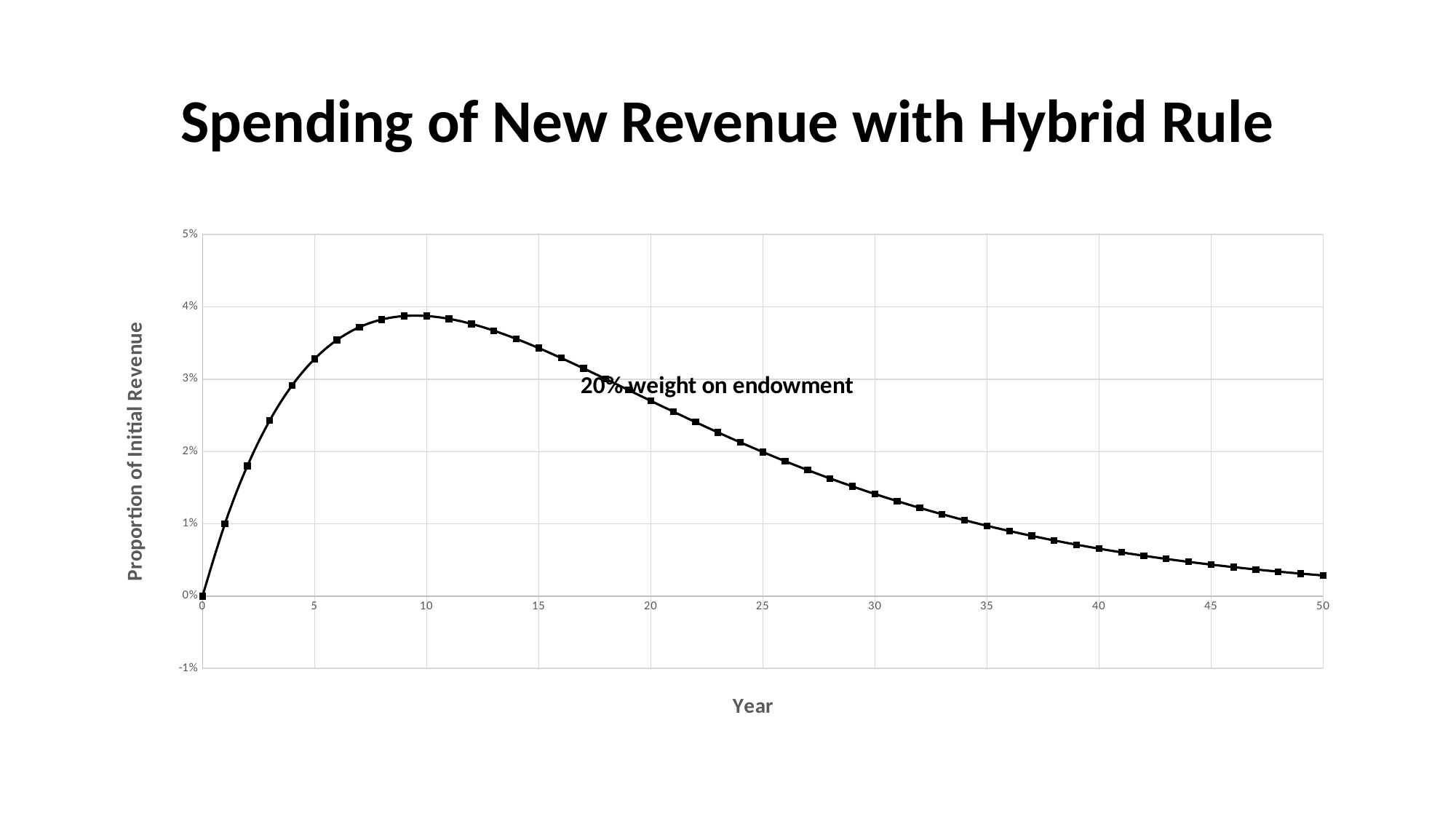
Is the value at year 30 greater or less than 2%? less Is the value at year 50 greater or less than 1%? less Which is larger, the value at year 10 or the value at year 30? year 10 Which is larger, the value at year 5 or the value at year 40? year 5 Do the values rise or fall between year 10 and year 50? fall What is the title of the chart? Spending of New Revenue with Hybrid Rule Is the value at year 5 greater or less than 3%? greater What kind of chart is shown on the slide? line chart What label is shown on the plotted line? 20% weight on endowment What is the value at year 0? 0% Do the values rise or fall between year 0 and year 8? rise